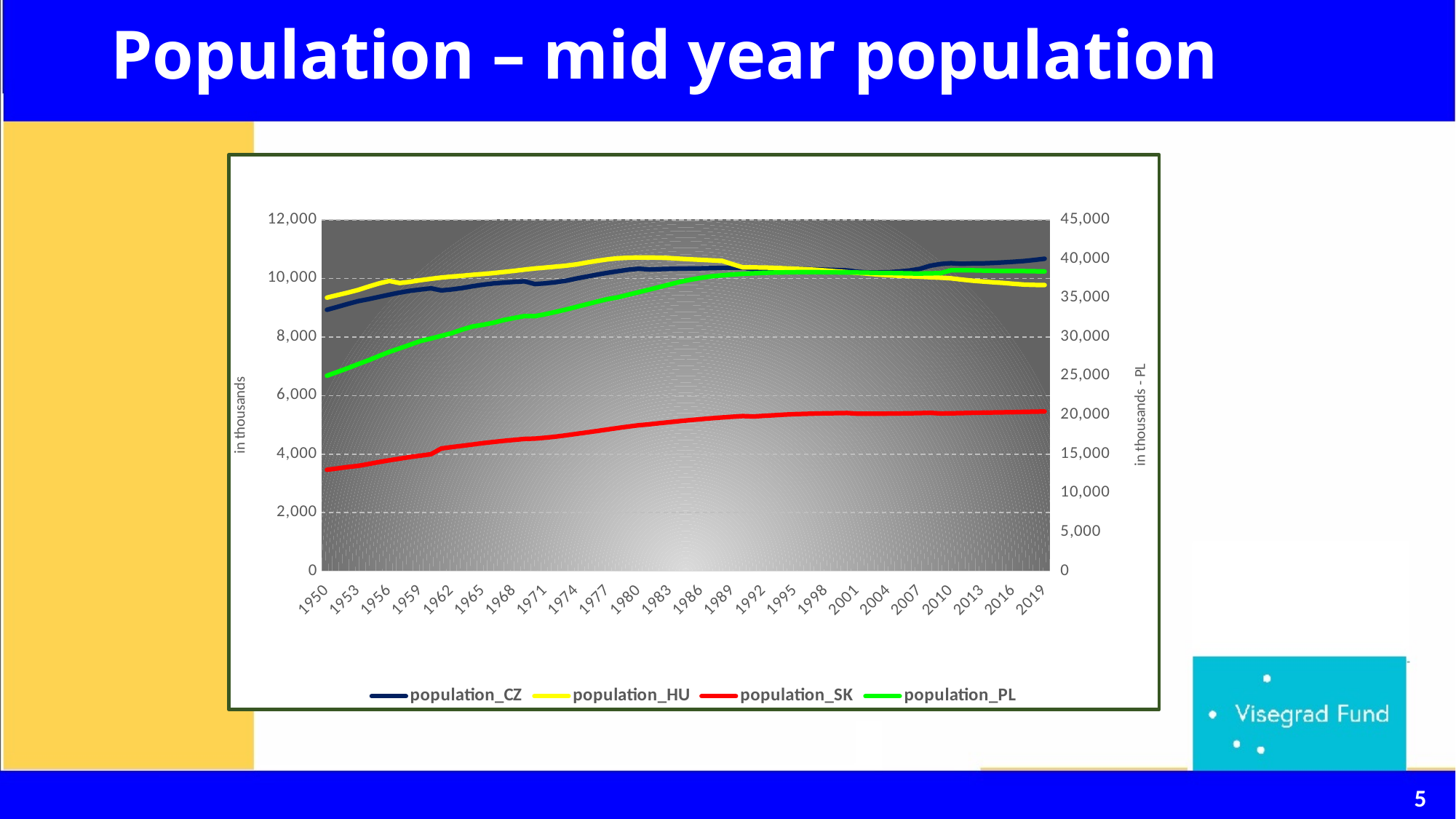
Is the value for population_CZ in 2019 greater or less than 10,000? greater How many series does the legend list? 4 Which series is plotted against the right-hand axis labelled 'in thousands - PL'? population_PL What kind of chart is shown on the slide? line chart Is the value for population_HU in 2019 greater or less than 10,000? less In 2019, which is larger, population_CZ or population_HU? population_CZ Does population_SK rise or fall from 1950 to 2019? rise Is the value for population_PL in 2019 greater or less than 35,000 on the right-hand axis? greater What are the series names listed in the legend? population_CZ, population_HU, population_SK, population_PL In 1950, which is larger, population_HU or population_CZ? population_HU Does population_HU rise or fall from 1980 to 2019? fall